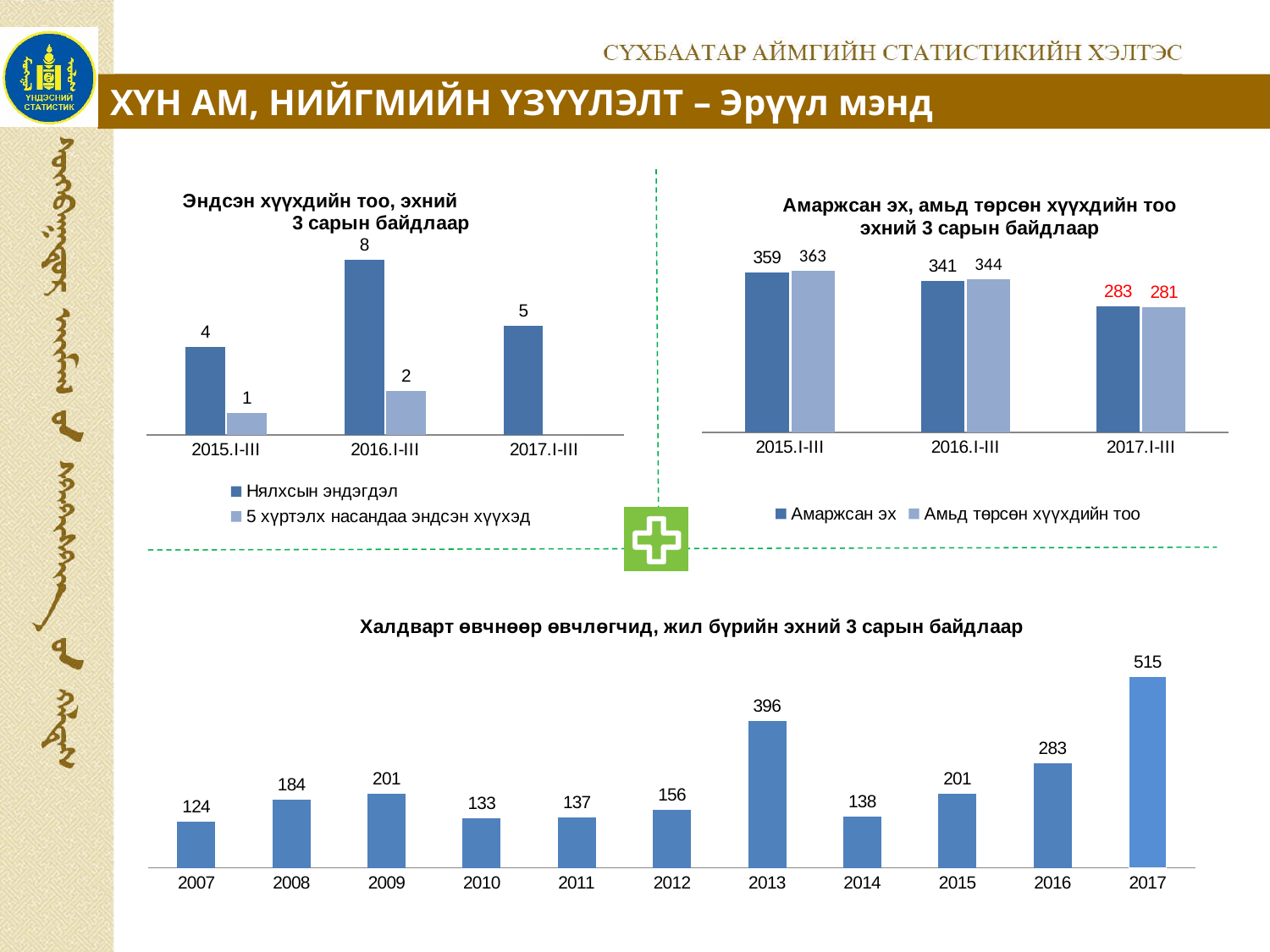
In the top-left chart 'Эндсэн хүүхдийн тоо, эхний 3 сарын байдлаар', which is larger for 2015.I-III: 'Нялхсын эндэгдэл' or '5 хүртэлх насандаа эндсэн хүүхэд'? Нялхсын эндэгдэл In the bottom chart 'Халдварт өвчнөөр өвчлөгчид, жил бүрийн эхний 3 сарын байдлаар', which year has the lowest value? 2007 In the top-right chart 'Амаржсан эх, амьд төрсөн хүүхдийн тоо эхний 3 сарын байдлаар', does the 'Амаржсан эх' series rise or fall from 2015.I-III to 2017.I-III? fall In the bottom chart 'Халдварт өвчнөөр өвчлөгчид, жил бүрийн эхний 3 сарын байдлаар', what is the difference between the values for 2017 and 2016? 232 In the top-left chart 'Эндсэн хүүхдийн тоо, эхний 3 сарын байдлаар', what is the value of 'Нялхсын эндэгдэл' for 2016.I-III? 8 In the bottom chart 'Халдварт өвчнөөр өвчлөгчид, жил бүрийн эхний 3 сарын байдлаар', what is the value for 2013? 396 What kind of chart is the top-left chart 'Эндсэн хүүхдийн тоо, эхний 3 сарын байдлаар'? bar chart In the bottom chart 'Халдварт өвчнөөр өвчлөгчид, жил бүрийн эхний 3 сарын байдлаар', which year has the highest value? 2017 How many years are shown on the x axis of the bottom chart 'Халдварт өвчнөөр өвчлөгчид, жил бүрийн эхний 3 сарын байдлаар'? 11 In the top-right chart 'Амаржсан эх, амьд төрсөн хүүхдийн тоо эхний 3 сарын байдлаар', what is the value of 'Амаржсан эх' for 2017.I-III? 283 How many series does the legend of the top-right chart 'Амаржсан эх, амьд төрсөн хүүхдийн тоо эхний 3 сарын байдлаар' list? 2 In the top-right chart 'Амаржсан эх, амьд төрсөн хүүхдийн тоо эхний 3 сарын байдлаар', what is the value of 'Амьд төрсөн хүүхдийн тоо' for 2015.I-III? 363